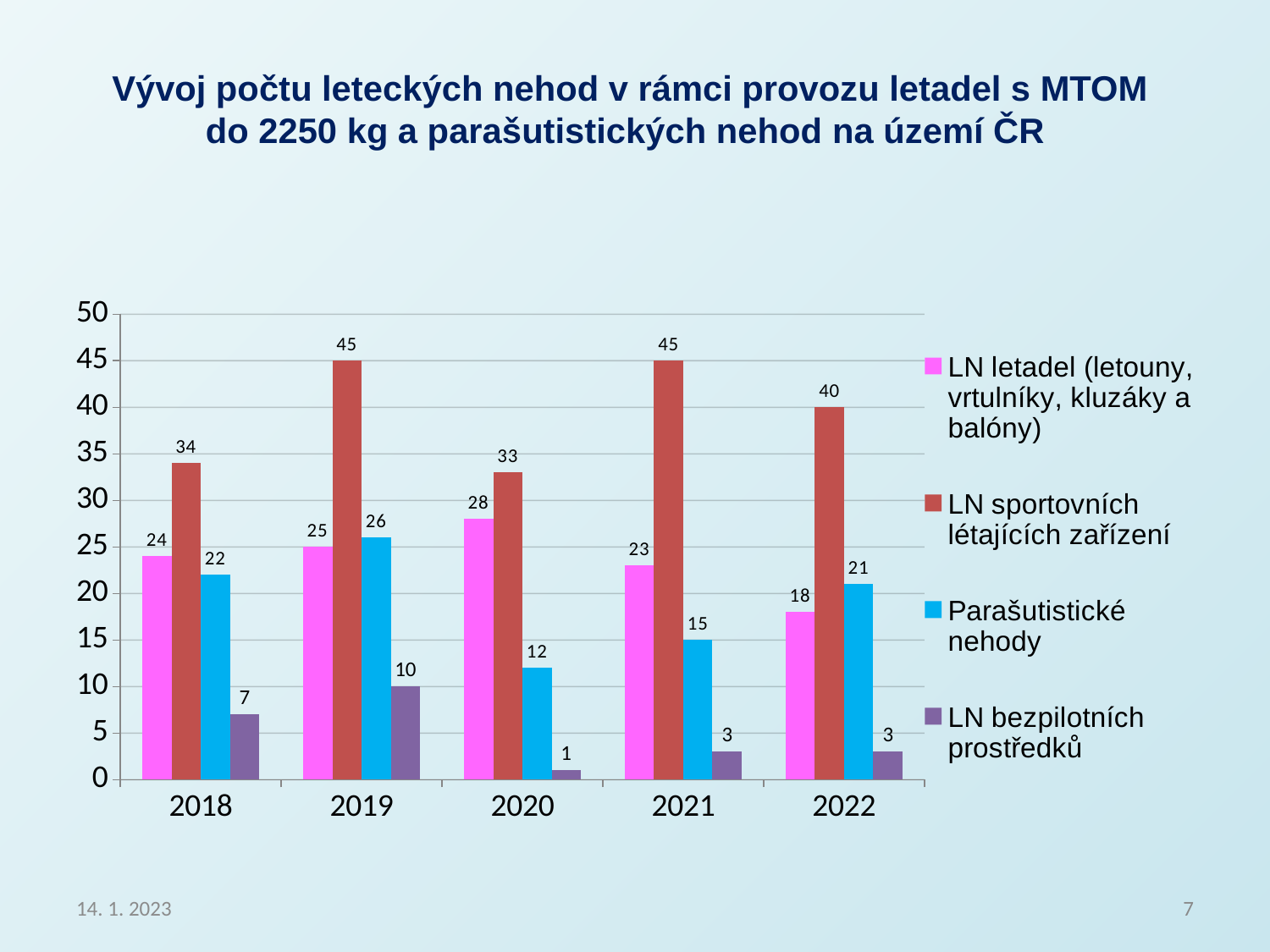
What is the value for Parašutistické nehody in 2020? 12 Which is larger in 2021: the value for LN letadel (letouny, vrtulníky, kluzáky a balóny) or the value for Parašutistické nehody? LN letadel (letouny, vrtulníky, kluzáky a balóny) What is the difference between the LN sportovních létajících zařízení value in 2019 and in 2018? 11 What is the value for LN bezpilotních prostředků in 2019? 10 What kind of chart is shown on the slide? Bar chart How many years are shown on the x axis? 5 In which year is the value for LN letadel (letouny, vrtulníky, kluzáky a balóny) the highest? 2020 How many series does the legend list? 4 Does the value for LN letadel (letouny, vrtulníky, kluzáky a balóny) rise or fall from 2020 to 2022? Fall What is the value for LN sportovních létajících zařízení in 2022? 40 What is the value for LN letadel (letouny, vrtulníky, kluzáky a balóny) in 2018? 24 In which year is the value for LN bezpilotních prostředků the lowest? 2020